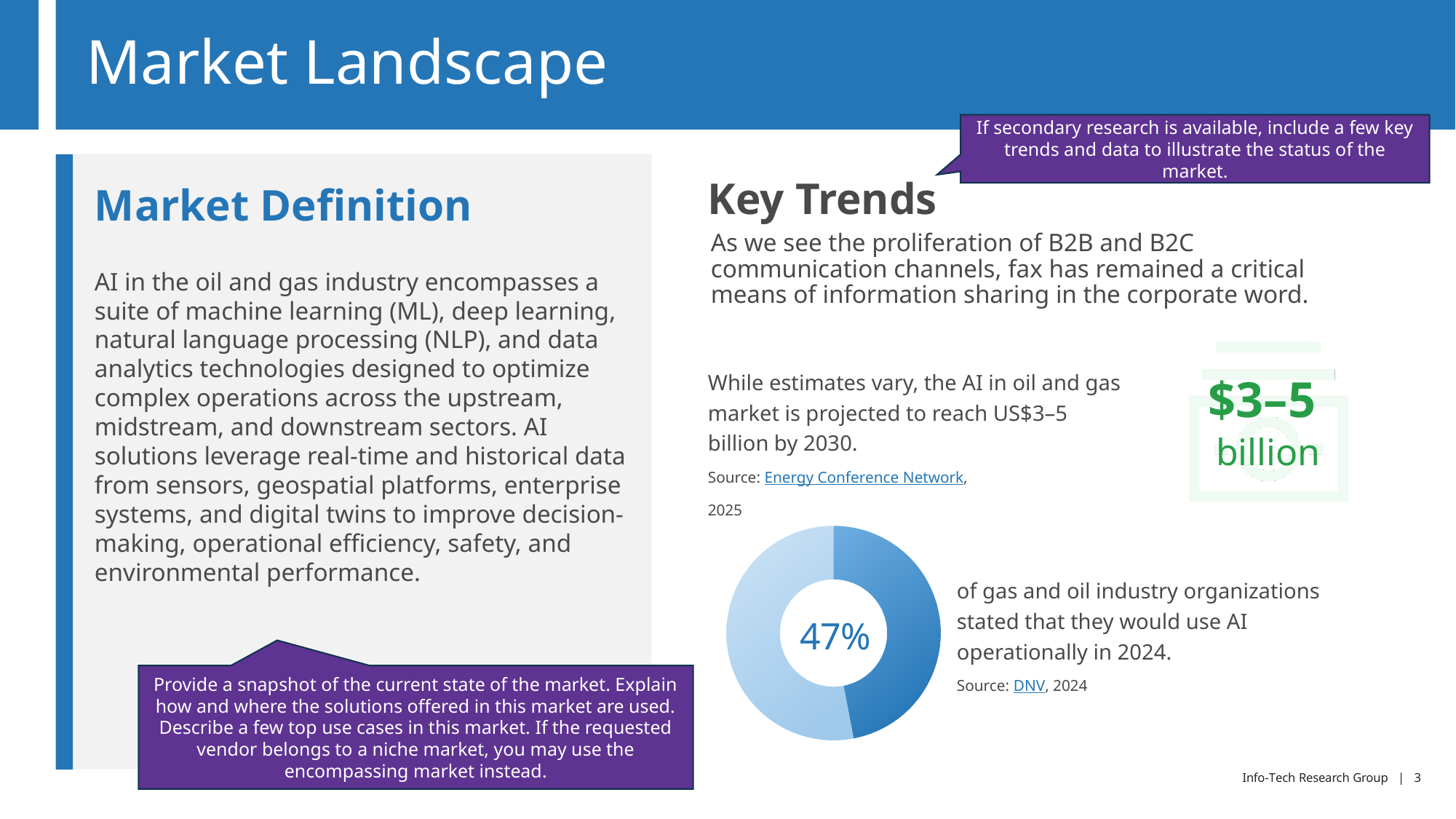
What share of the donut chart does the darker blue slice represent? 47% What kind of chart is shown on the slide? Donut (pie) chart Does the donut chart include a legend? No According to the text beside the donut chart, what does the 47% represent? Gas and oil industry organizations that stated they would use AI operationally in 2024 How many slices does the donut chart have? 2 What source is cited for the 47% figure in the donut chart? DNV, 2024 What percentage is printed in the centre of the donut chart? 47% Is the value shown in the donut chart greater or less than 50%? less